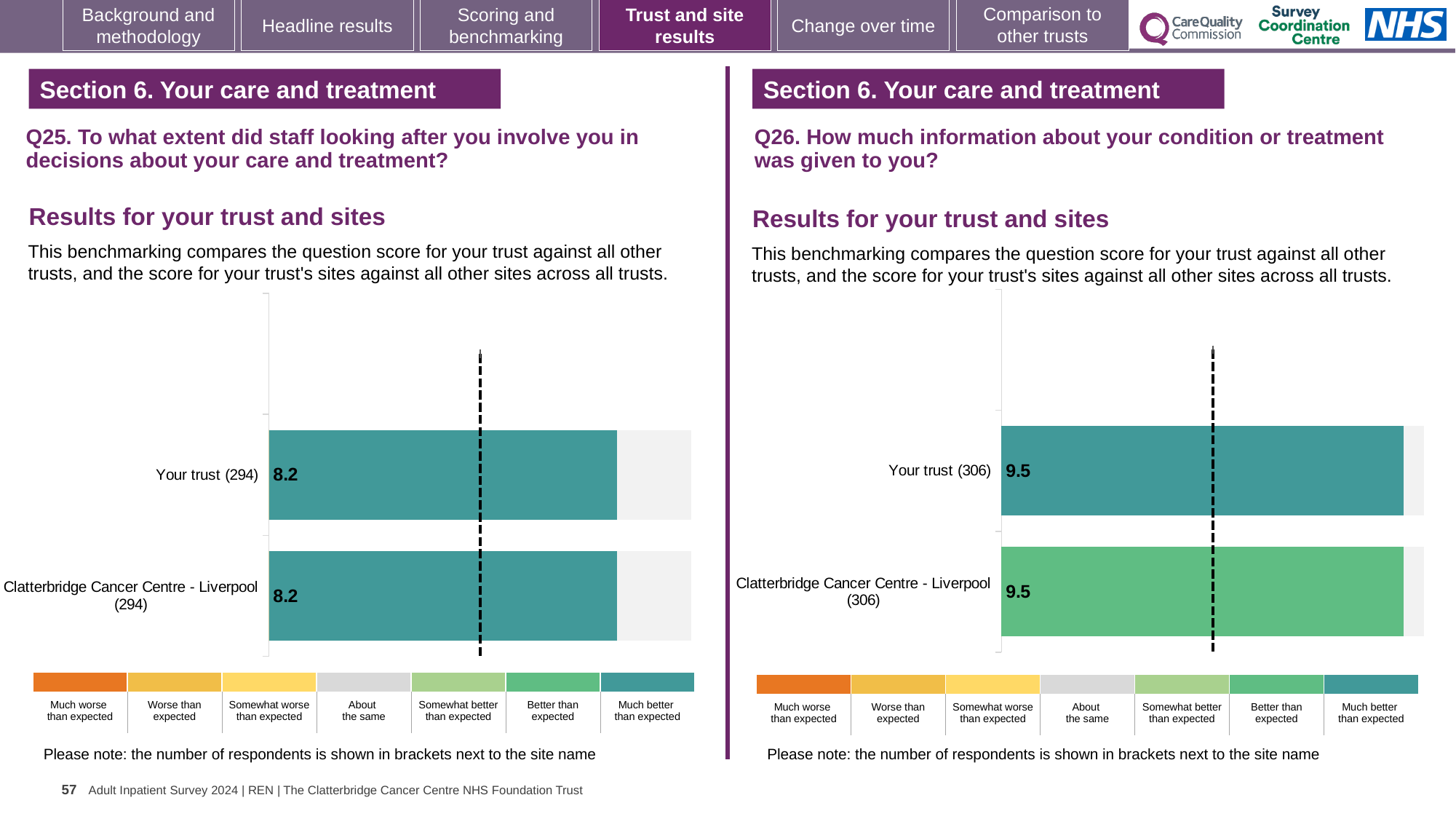
In the Q26 chart on the right, which benchmark category does the colour of the Clatterbridge Cancer Centre - Liverpool bar correspond to in the key? Better than expected In the Q26 chart on the right, what is the score for Your trust (306)? 9.5 How many bars are plotted in the Q26 chart on the right? 2 In the Q26 chart on the right, what is the score for Clatterbridge Cancer Centre - Liverpool (306)? 9.5 In the Q25 chart on the left, what is the score for Clatterbridge Cancer Centre - Liverpool (294)? 8.2 In the Q25 chart on the left, what is the score for Your trust (294)? 8.2 In the Q25 chart on the left, what is the difference between the score for Your trust and the score for Clatterbridge Cancer Centre - Liverpool? 0 How many bars are plotted in the Q25 chart on the left? 2 What kind of chart is used for the Q25 results on the left? Bar chart How many respondents are shown in brackets for Your trust in the Q26 chart on the right? 306 In the Q26 chart on the right, what is the difference between the score for Your trust and the score for Clatterbridge Cancer Centre - Liverpool? 0